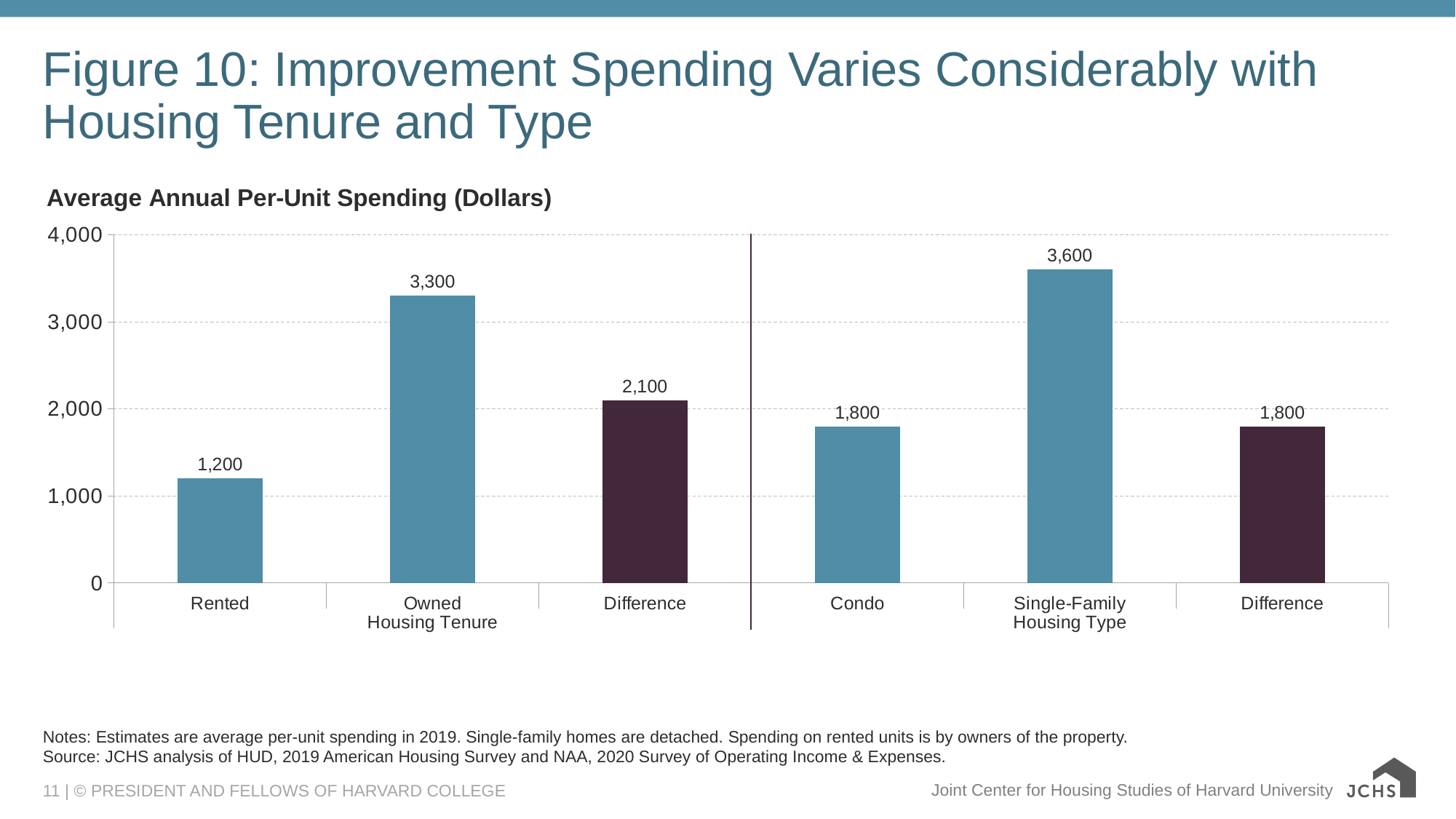
What is the average annual per-unit spending for Condo units? 1,800 How many bars are shown in the chart? 6 How much higher is spending on Owned units than on Rented units? 2,100 Which category has the lowest average annual per-unit spending? Rented What is the average annual per-unit spending for Rented units? 1,200 What is the average annual per-unit spending for Single-Family homes? 3,600 What type of chart is shown on the slide? Bar chart What is the average annual per-unit spending for Owned units? 3,300 Which has higher average annual per-unit spending, Condo or Owned? Owned Is the value for Single-Family greater or less than 3,000? greater Which category has the highest average annual per-unit spending? Single-Family What is the value of the Difference bar in the Housing Tenure group? 2,100